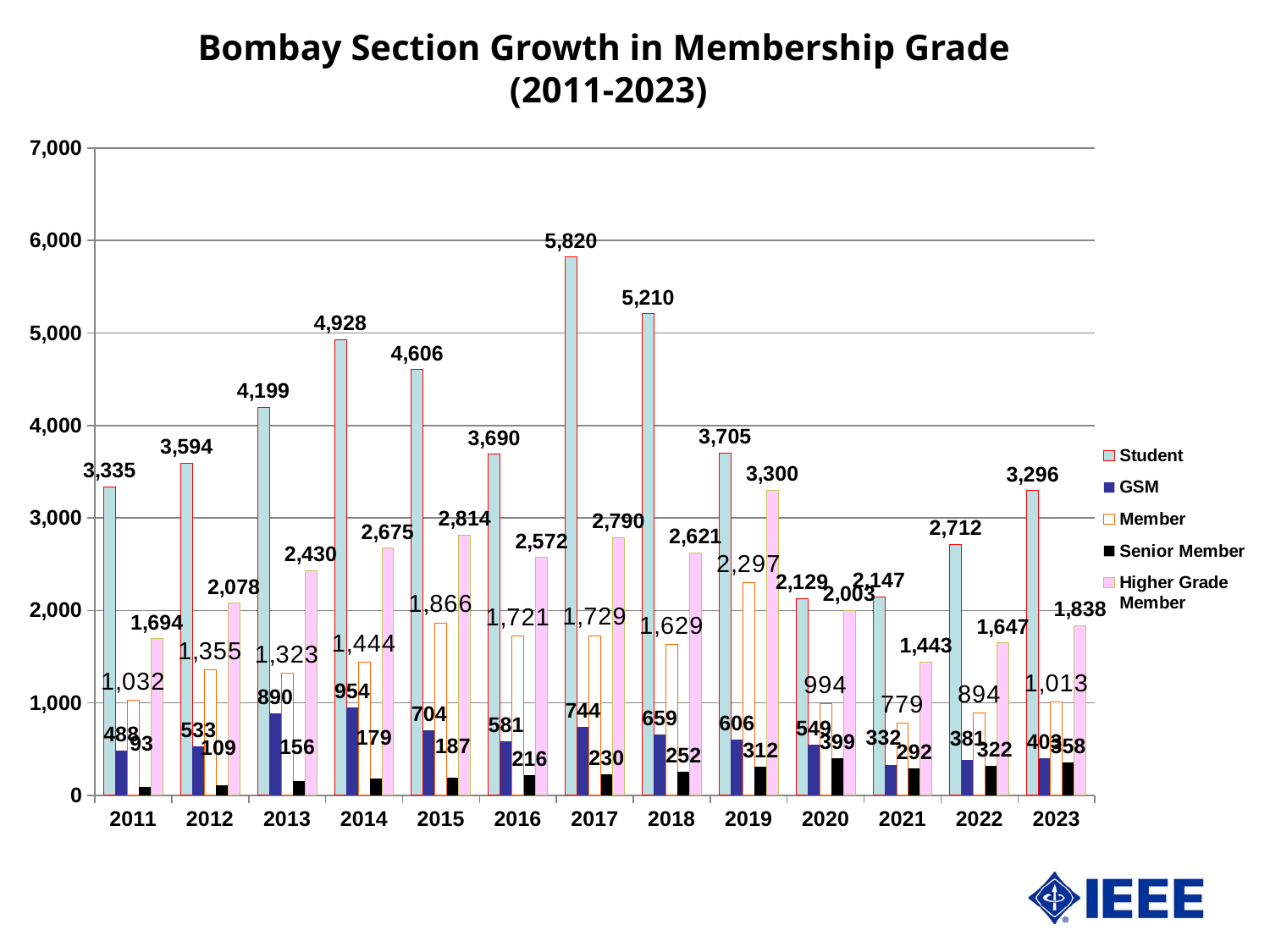
Does the Senior Member value rise or fall from 2011 to 2019? Rise What kind of chart is shown? Bar chart In which year is the Student value highest? 2017 What is the Senior Member value for 2011? 93 What is the Higher Grade Member value for 2019? 3,300 In which year is the Student value lowest? 2020 What is the Student value for 2017? 5,820 What is the GSM value for 2014? 954 What is the difference between the Student values for 2017 and 2018? 610 How many series does the legend list? 5 How many years are shown on the x axis? 13 In 2019, which is larger: Member or Higher Grade Member? Higher Grade Member